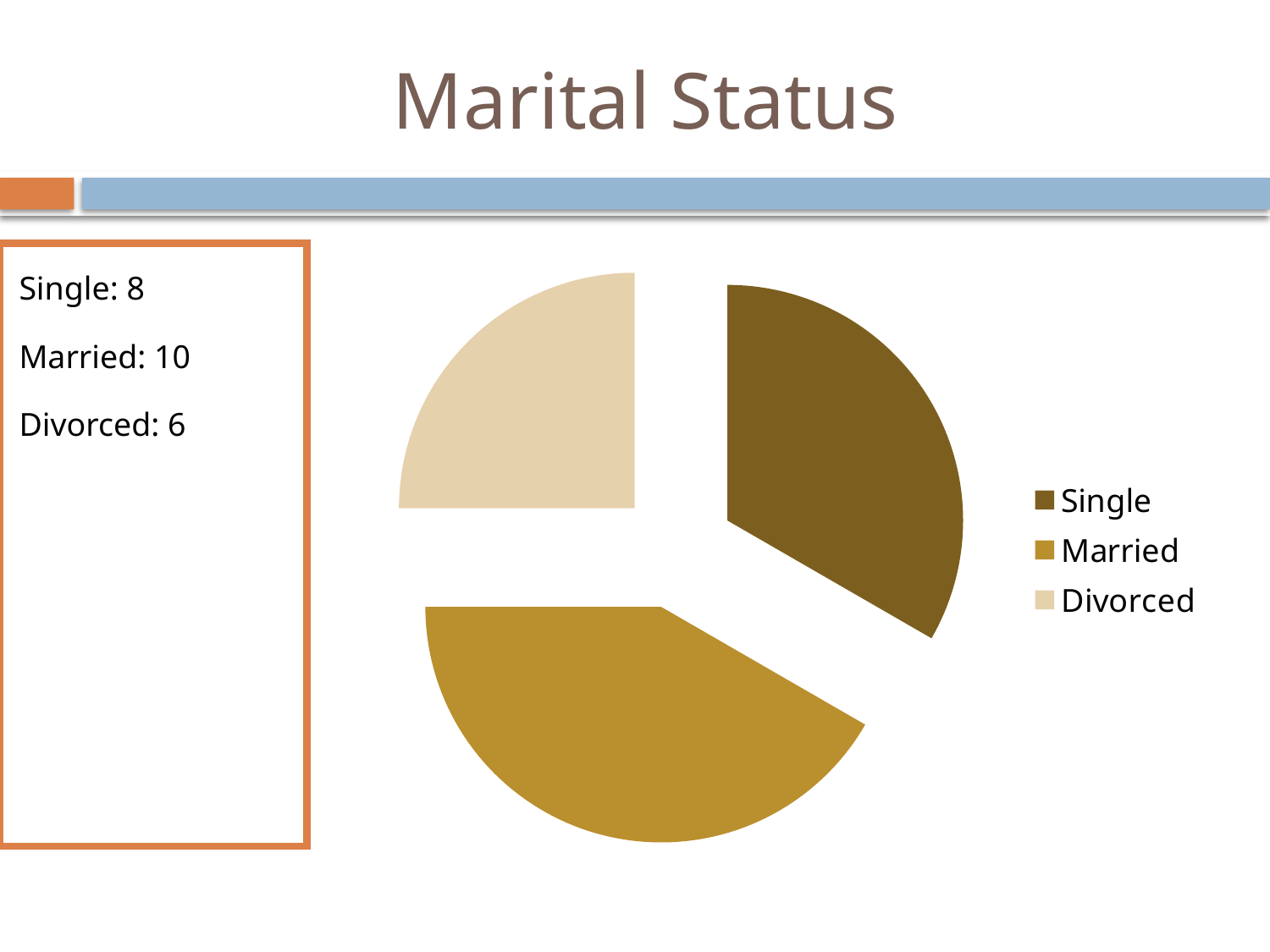
What is the value for Married? 10 Which category has the smallest slice of the pie? Divorced What share of the pie does the Divorced slice represent? 25% What type of chart is shown on the slide? pie chart How many categories does the pie chart have? 3 What is the value for Divorced? 6 What is the value for Single? 8 Which is larger, the value for Single or the value for Married? Married What is the difference between the values for Married and Divorced? 4 What is the title of the chart on the slide? Marital Status Which category has the largest slice of the pie? Married How many entries does the legend list? 3